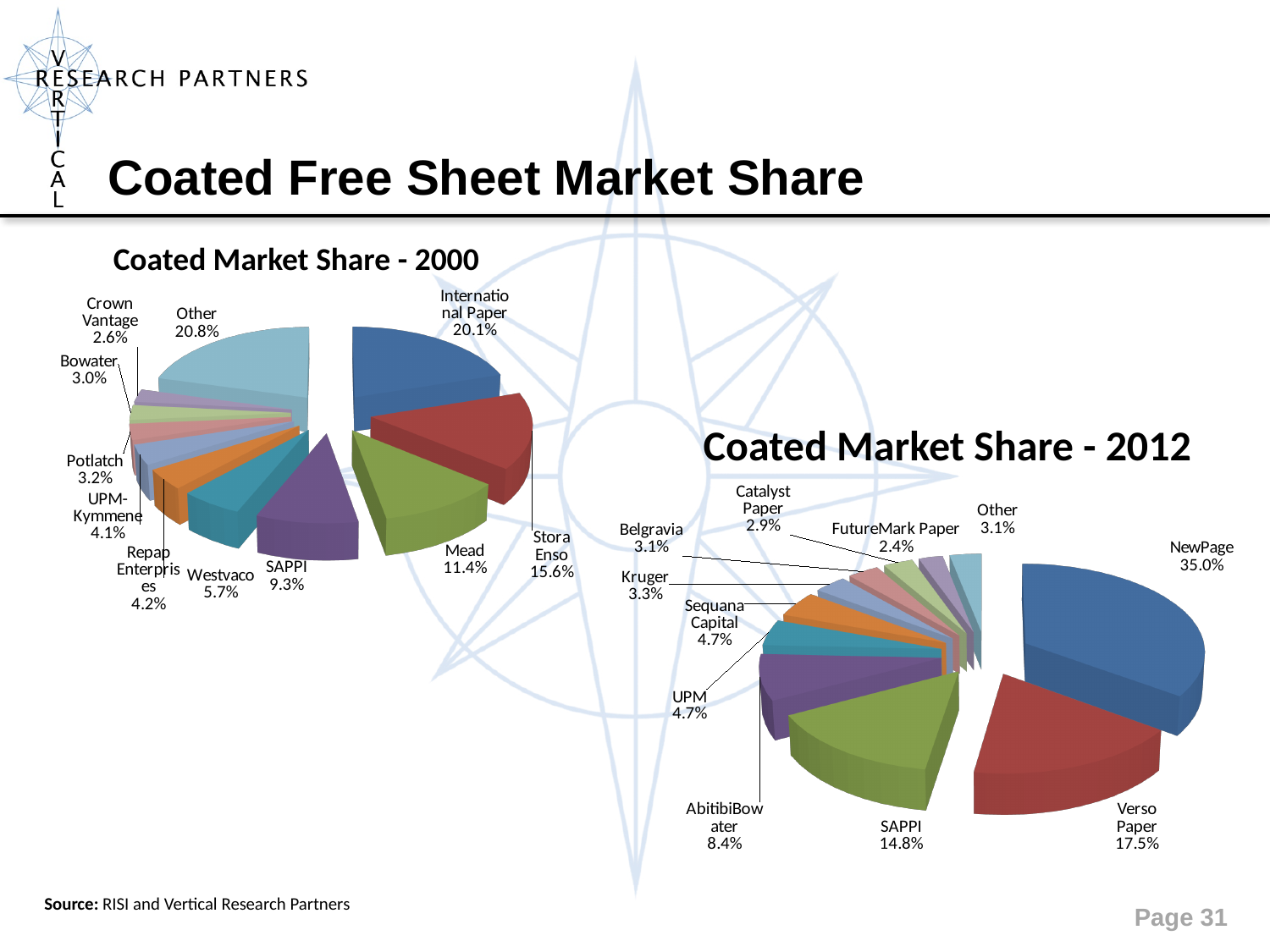
In the Coated Market Share - 2000 chart, what is the difference between Stora Enso's share and Mead's share? 4.2% What type of chart is the Coated Market Share - 2000 chart? Pie chart In the Coated Market Share - 2012 chart, which company has the largest share? NewPage In the Coated Market Share - 2012 chart, which slice is the smallest? FutureMark Paper In the Coated Market Share - 2000 chart, what share does International Paper hold? 20.1% In the Coated Market Share - 2000 chart, which is larger, SAPPI's share or Westvaco's share? SAPPI What is the title of the chart on the right side of the slide? Coated Market Share - 2012 How many slices does the Coated Market Share - 2012 chart have? 11 In the Coated Market Share - 2012 chart, what is the difference between NewPage's share and Verso Paper's share? 17.5% In the Coated Market Share - 2012 chart, what share does NewPage hold? 35.0% In the Coated Market Share - 2000 chart, which slice is the smallest? Crown Vantage In the Coated Market Share - 2012 chart, what share does AbitibiBowater hold? 8.4%